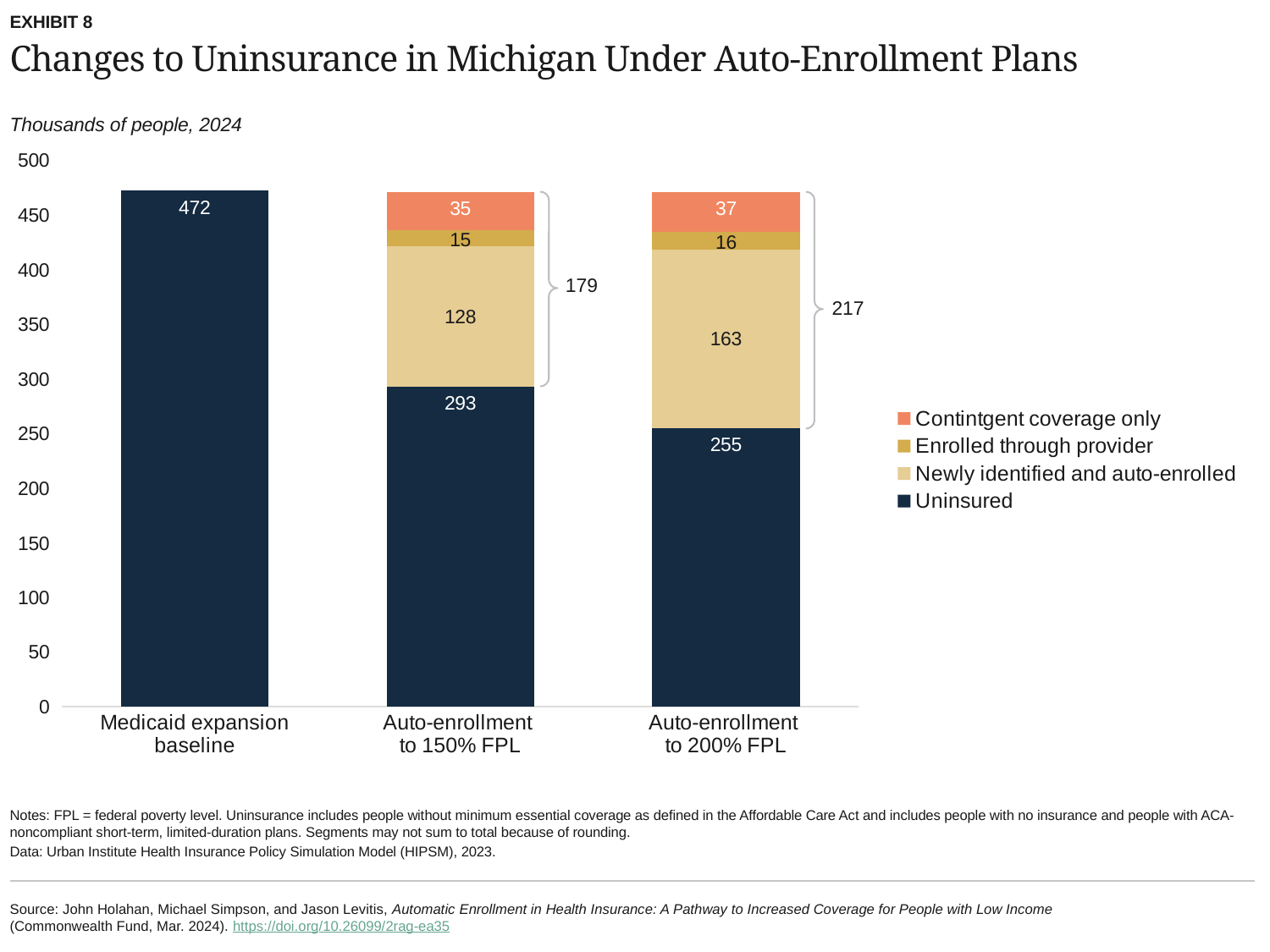
Which category has the lowest Uninsured value? Auto-enrollment to 200% FPL What is the Newly identified and auto-enrolled value under Auto-enrollment to 200% FPL? 163 What is the Uninsured value for the Medicaid expansion baseline? 472 What is the Uninsured value under Auto-enrollment to 150% FPL? 293 Is the Newly identified and auto-enrolled value larger under Auto-enrollment to 150% FPL or Auto-enrollment to 200% FPL? Auto-enrollment to 200% FPL What is the Enrolled through provider value under Auto-enrollment to 200% FPL? 16 What value does the bracket next to the Auto-enrollment to 200% FPL bar show? 217 How many series does the legend list? 4 What kind of chart is shown? Stacked bar chart How many categories are shown on the x axis? 3 What is the Contingent coverage only value under Auto-enrollment to 150% FPL? 35 What is the difference between the Uninsured values for Auto-enrollment to 150% FPL and Auto-enrollment to 200% FPL? 38